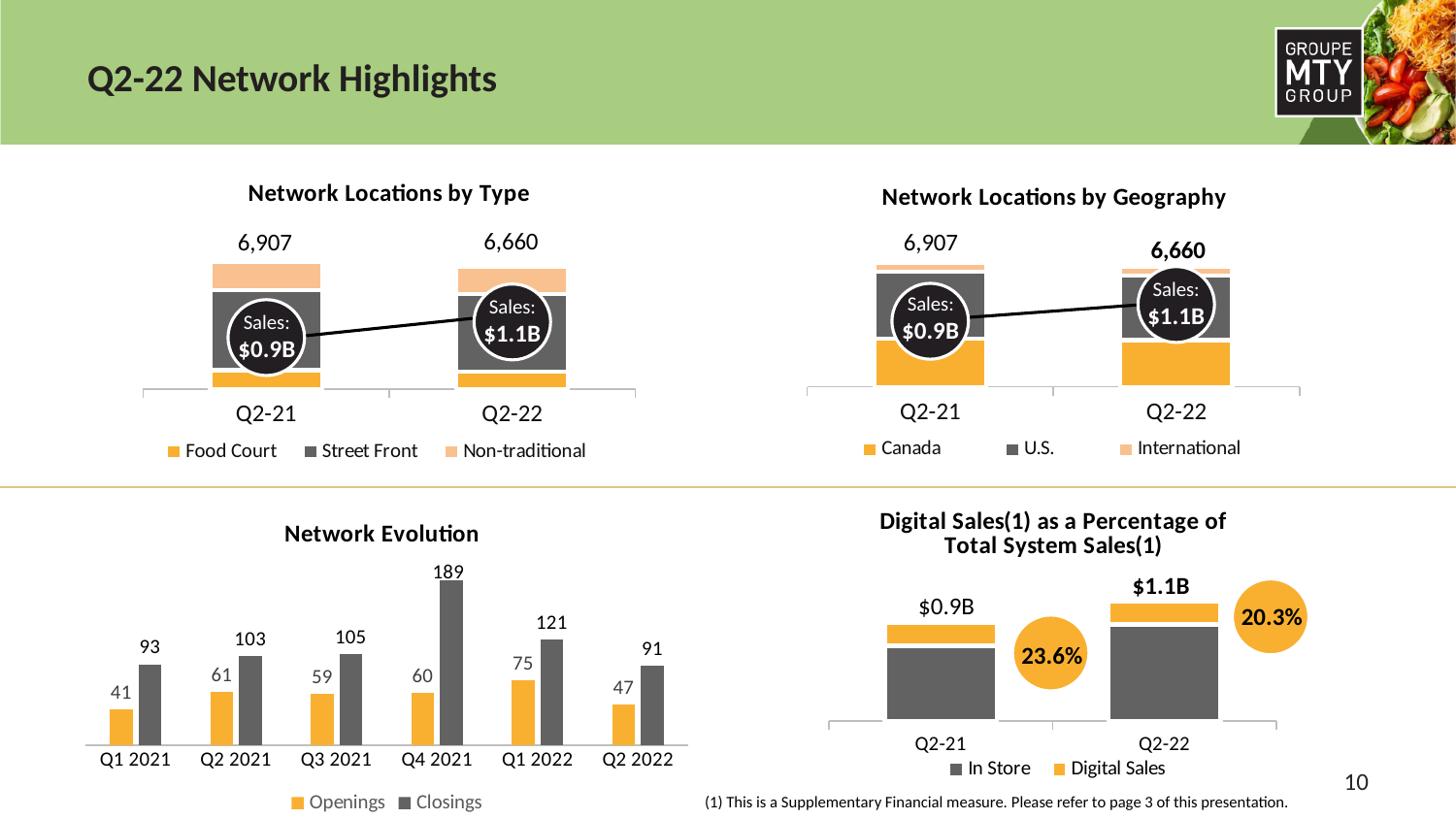
What kind of chart is the Network Evolution chart? Bar chart In the Network Evolution chart, which quarter had the highest number of closings? Q4 2021 In the Network Evolution chart, how many closings were there in Q4 2021? 189 In the Network Locations by Type chart, what is the total number of network locations in Q2-22? 6,660 In the Network Evolution chart, how many openings were there in Q2 2022? 47 In the Network Evolution chart, how many series does the legend list? 2 In the Digital Sales as a Percentage of Total System Sales chart, what was the digital sales percentage in Q2-21? 23.6% In the Network Locations by Geography chart, what is the difference in total network locations between Q2-21 and Q2-22? 247 In the Network Evolution chart, what is the difference between closings and openings in Q1 2022? 46 In the Network Locations by Geography chart, which three regions does the legend list? Canada, U.S., International In the Network Evolution chart, which quarter had the lowest number of openings? Q1 2021 In the Network Evolution chart, how many quarters are shown on the x axis? 6